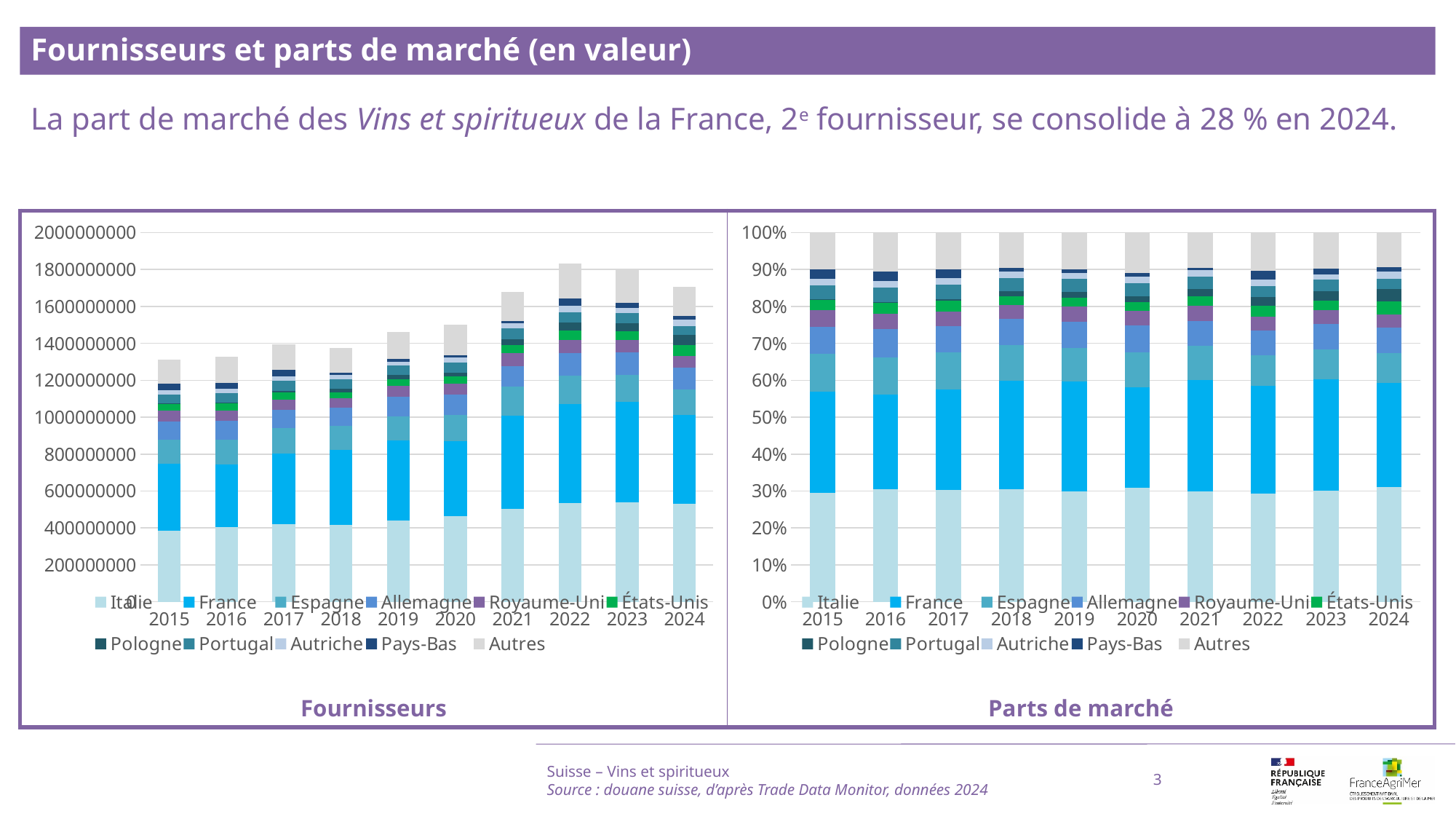
How many years are shown on the x axis of the 'Parts de marché' chart? 10 In the 'Fournisseurs' chart, do the total bar heights generally rise or fall from 2015 to 2022? rise How many series does the legend of the 'Fournisseurs' chart list? 11 In the 'Parts de marché' chart, is the combined share of Italie and France in 2024 greater or less than 50%? greater In the 'Parts de marché' chart, is the share of Italie in 2018 greater or less than 40%? less In the 'Fournisseurs' chart, is the total stacked bar for 2015 greater or less than 1400000000? less In the 'Fournisseurs' chart, which year has the tallest total stacked bar? 2022 What kind of chart is the 'Fournisseurs' chart on the left? stacked bar chart What is the title shown under the right-hand chart? Parts de marché Which series is plotted at the bottom of each stacked bar in the 'Parts de marché' chart? Italie In the 'Fournisseurs' chart, is the total bar for 2022 larger or smaller than the total bar for 2015? larger